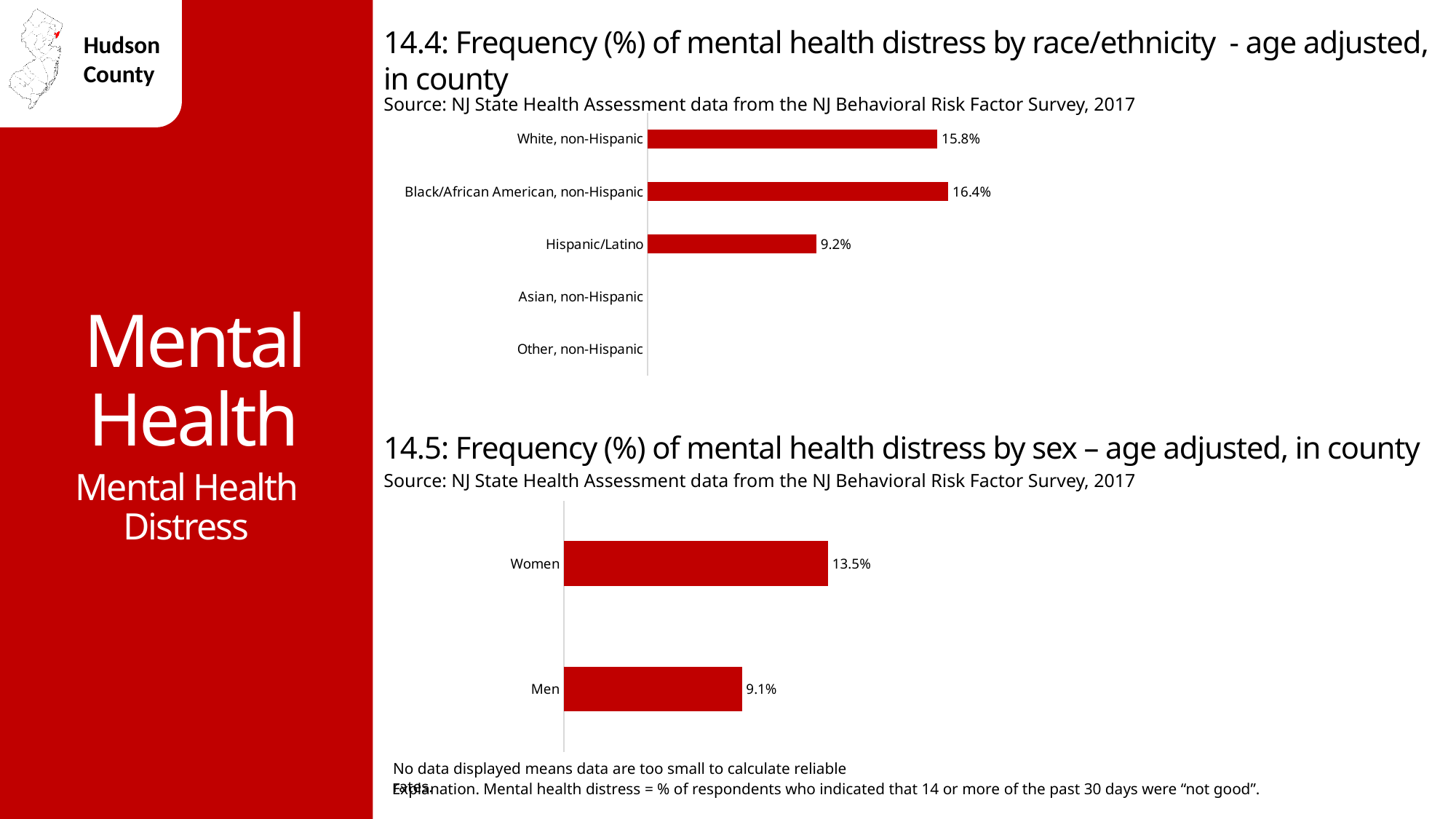
In chart 14.4 (mental health distress by race/ethnicity), how many race/ethnicity categories are listed on the axis? 5 In chart 14.4 (mental health distress by race/ethnicity), what is the value for Hispanic/Latino? 9.2% In chart 14.4 (mental health distress by race/ethnicity), what is the difference between the Black/African American, non-Hispanic and Hispanic/Latino values? 7.2% In chart 14.4 (mental health distress by race/ethnicity), what is the value for White, non-Hispanic? 15.8% In chart 14.5 (mental health distress by sex), what is the value for Women? 13.5% In chart 14.5 (mental health distress by sex), what is the value for Men? 9.1% In chart 14.5 (mental health distress by sex), what is the difference between the Women and Men values? 4.4% In chart 14.5 (mental health distress by sex), which group has the higher value, Women or Men? Women In chart 14.4 (mental health distress by race/ethnicity), which categories have no bar displayed? Asian, non-Hispanic and Other, non-Hispanic In chart 14.4 (mental health distress by race/ethnicity), which of White, non-Hispanic or Hispanic/Latino has the larger value? White, non-Hispanic What kind of chart is chart 14.5 (mental health distress by sex)? Bar chart In chart 14.4 (mental health distress by race/ethnicity), which race/ethnicity group has the highest value? Black/African American, non-Hispanic